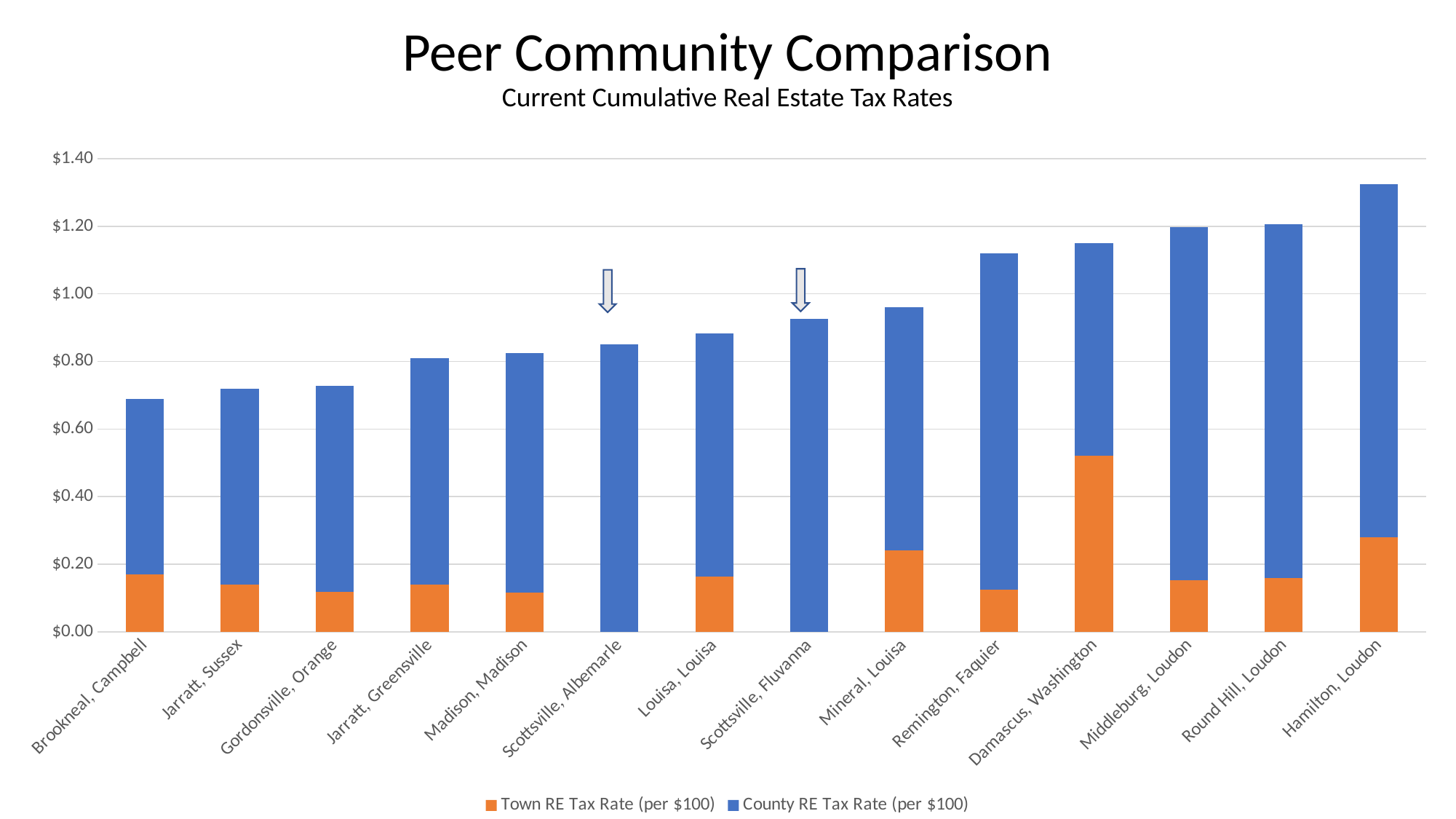
Is the cumulative tax rate for Hamilton, Loudon greater or less than $1.20? greater Which community has the lowest cumulative real estate tax rate? Brookneal, Campbell Which community has the highest cumulative real estate tax rate? Hamilton, Loudon Is the cumulative tax rate for Brookneal, Campbell greater or less than $0.80? less What kind of chart is shown on the slide? Stacked bar chart How many communities are plotted on the x axis? 14 Which community has the largest Town RE Tax Rate segment? Damascus, Washington How many series does the legend list? 2 Is the Town RE Tax Rate for Damascus, Washington greater or less than $0.40? greater Which two communities have no Town RE Tax Rate segment in their bars? Scottsville, Albemarle and Scottsville, Fluvanna Do the cumulative tax rates rise or fall moving from left to right along the x axis? Rise Which has a higher cumulative tax rate, Mineral, Louisa or Louisa, Louisa? Mineral, Louisa